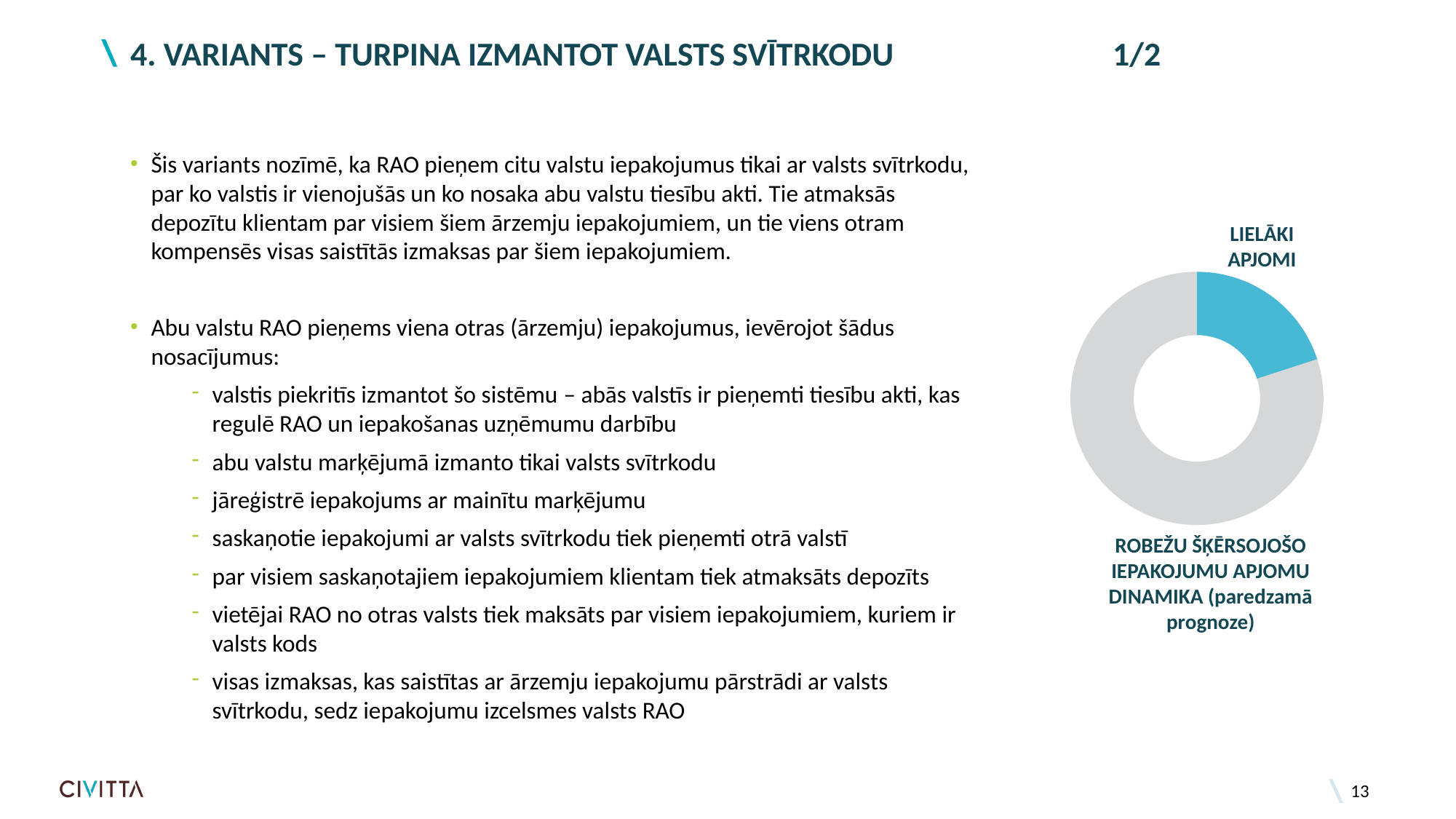
How many slices does the donut chart on the slide have? 2 What label is placed next to the blue slice of the donut chart? LIELĀKI APJOMI Which slice of the donut chart is the smallest? The blue slice (LIELĀKI APJOMI) Which slice of the donut chart is larger, the blue one or the grey one? The grey one What caption appears below the donut chart? ROBEŽU ŠĶĒRSOJOŠO IEPAKOJUMU APJOMU DINAMIKA (paredzamā prognoze) What kind of chart is shown on the right side of the slide? Donut (pie) chart